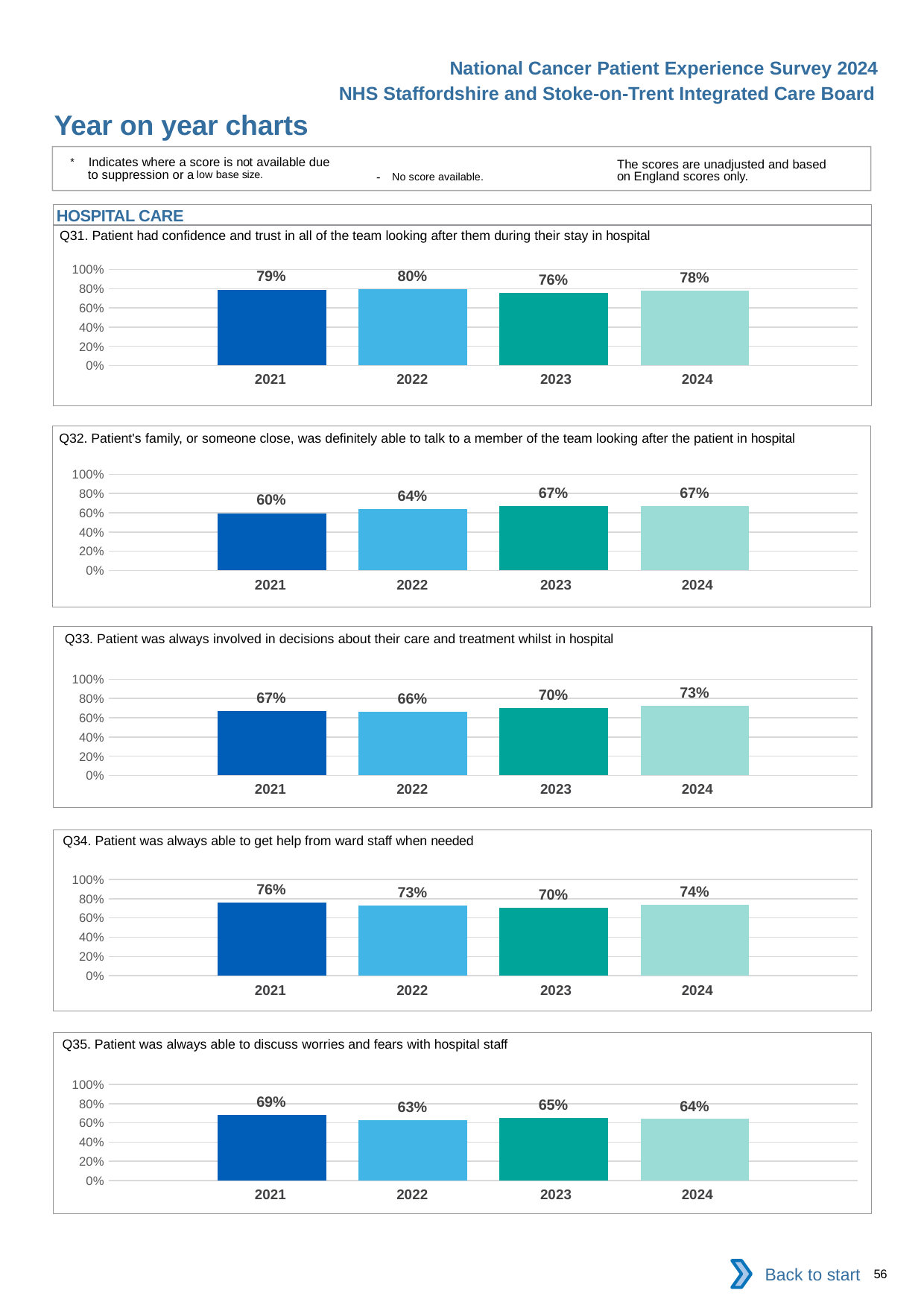
In the Q33 chart, what is the difference between the 2024 and 2021 values? 6% In the Q35 chart, what is the value for 2023? 65% In the Q31 chart, what is the value for 2022? 80% In the Q32 chart, which year has the lowest value? 2021 What kind of chart is the Q34 chart? bar chart In the Q35 chart, what is the difference between the 2021 and 2022 values? 6% In the Q32 chart, do the values rise or fall from 2021 to 2023? rise In the Q34 chart, is the value for 2023 greater or less than 60%? greater What is the section heading above the Q31 chart? HOSPITAL CARE In the Q31 chart, which is larger, the value for 2023 or the value for 2024? 2024 How many years are shown in the Q33 chart? 4 In the Q34 chart, which year has the highest value? 2021